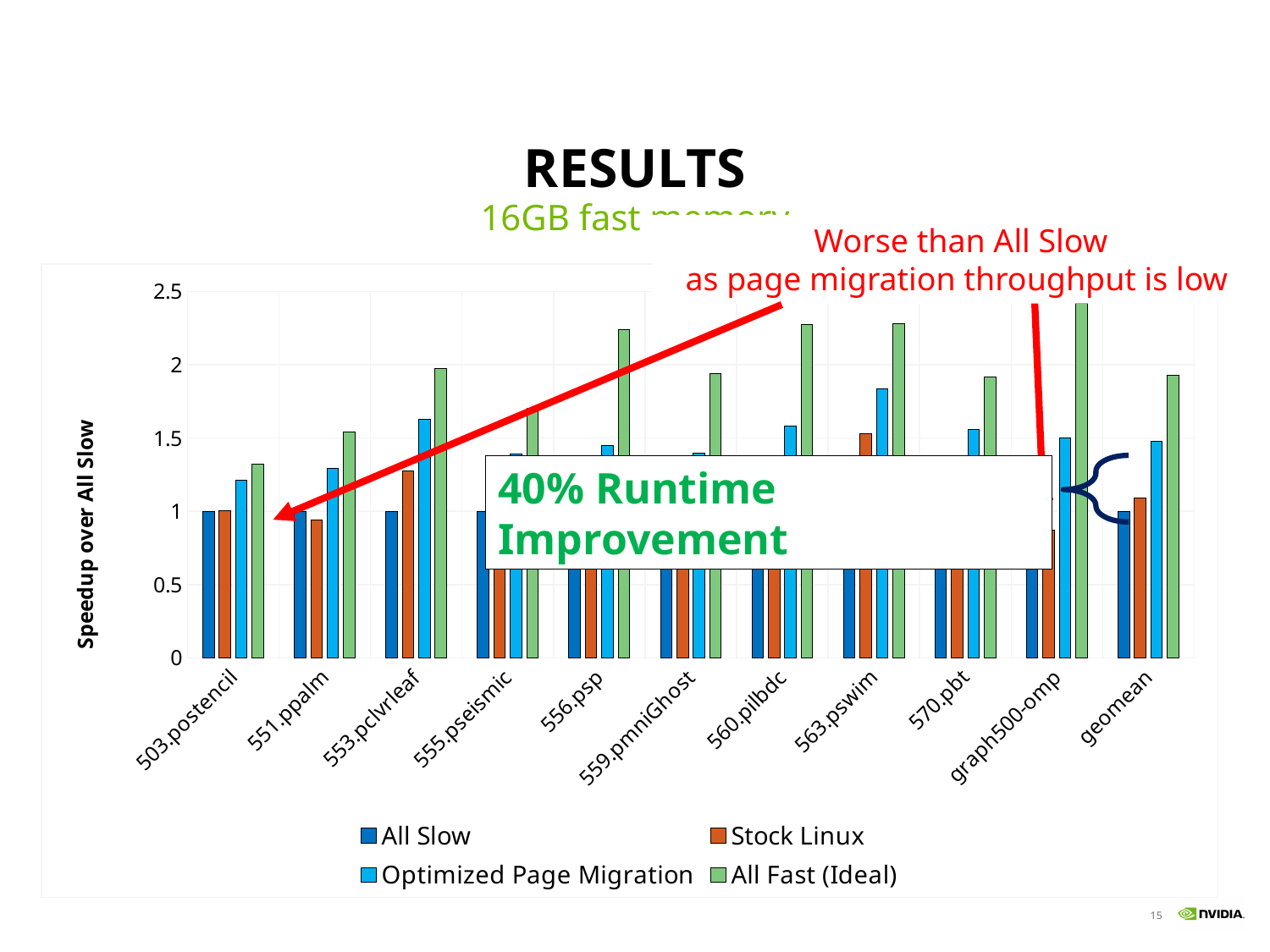
How many categories are shown along the x axis? 11 How many series does the legend list? 4 For 563.pswim, which is larger: Optimized Page Migration or All Fast (Ideal)? All Fast (Ideal) What is the title of the y axis? Speedup over All Slow What kind of chart is shown on the slide? bar chart What is the All Slow value for 503.postencil? 1 Is the Optimized Page Migration value for 503.postencil greater or less than 1.5? less Which category has the highest All Fast (Ideal) value? graph500-omp Is the All Fast (Ideal) value for graph500-omp greater or less than 2? greater For 553.pclvrleaf, which is larger: Stock Linux or Optimized Page Migration? Optimized Page Migration Is the Optimized Page Migration value for geomean greater or less than 1? greater Which category has the lowest All Fast (Ideal) value? 503.postencil